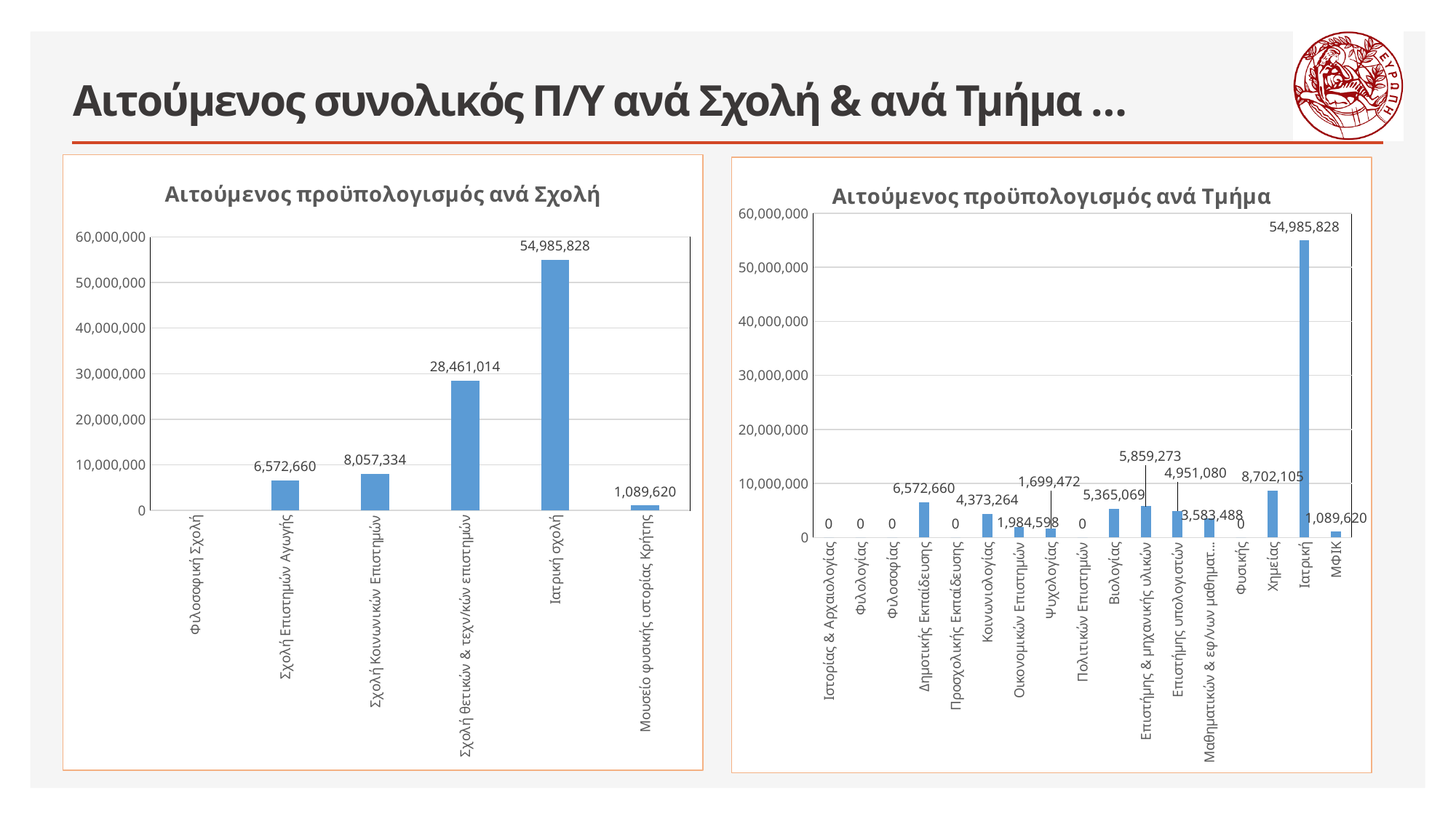
In the chart 'Αιτούμενος προϋπολογισμός ανά Τμήμα', how many categories are shown on the x axis? 17 In the chart 'Αιτούμενος προϋπολογισμός ανά Τμήμα', what is the value for Χημείας? 8,702,105 In the chart 'Αιτούμενος προϋπολογισμός ανά Σχολή', what is the value for Σχολή Κοινωνικών Επιστημών? 8,057,334 What type of chart is 'Αιτούμενος προϋπολογισμός ανά Σχολή'? Bar chart In the chart 'Αιτούμενος προϋπολογισμός ανά Τμήμα', what is the value for Κοινωνιολογίας? 4,373,264 In the chart 'Αιτούμενος προϋπολογισμός ανά Τμήμα', which is larger, Βιολογίας or Επιστήμης & μηχανικής υλικών? Επιστήμης & μηχανικής υλικών In the chart 'Αιτούμενος προϋπολογισμός ανά Τμήμα', which category has the highest value? Ιατρική In the chart 'Αιτούμενος προϋπολογισμός ανά Σχολή', what is the difference between Ιατρική σχολή and Σχολή θετικών & τεχν/κών επιστημών? 26,524,814 In the chart 'Αιτούμενος προϋπολογισμός ανά Σχολή', what is the value for Ιατρική σχολή? 54,985,828 In the chart 'Αιτούμενος προϋπολογισμός ανά Τμήμα', what is the difference between Δημοτικής Εκπαίδευσης and Ψυχολογίας? 4,873,188 In the chart 'Αιτούμενος προϋπολογισμός ανά Σχολή', how many categories are shown on the x axis? 6 In the chart 'Αιτούμενος προϋπολογισμός ανά Σχολή', which category has the lowest labelled non-zero value? Μουσείο φυσικής ιστορίας Κρήτης